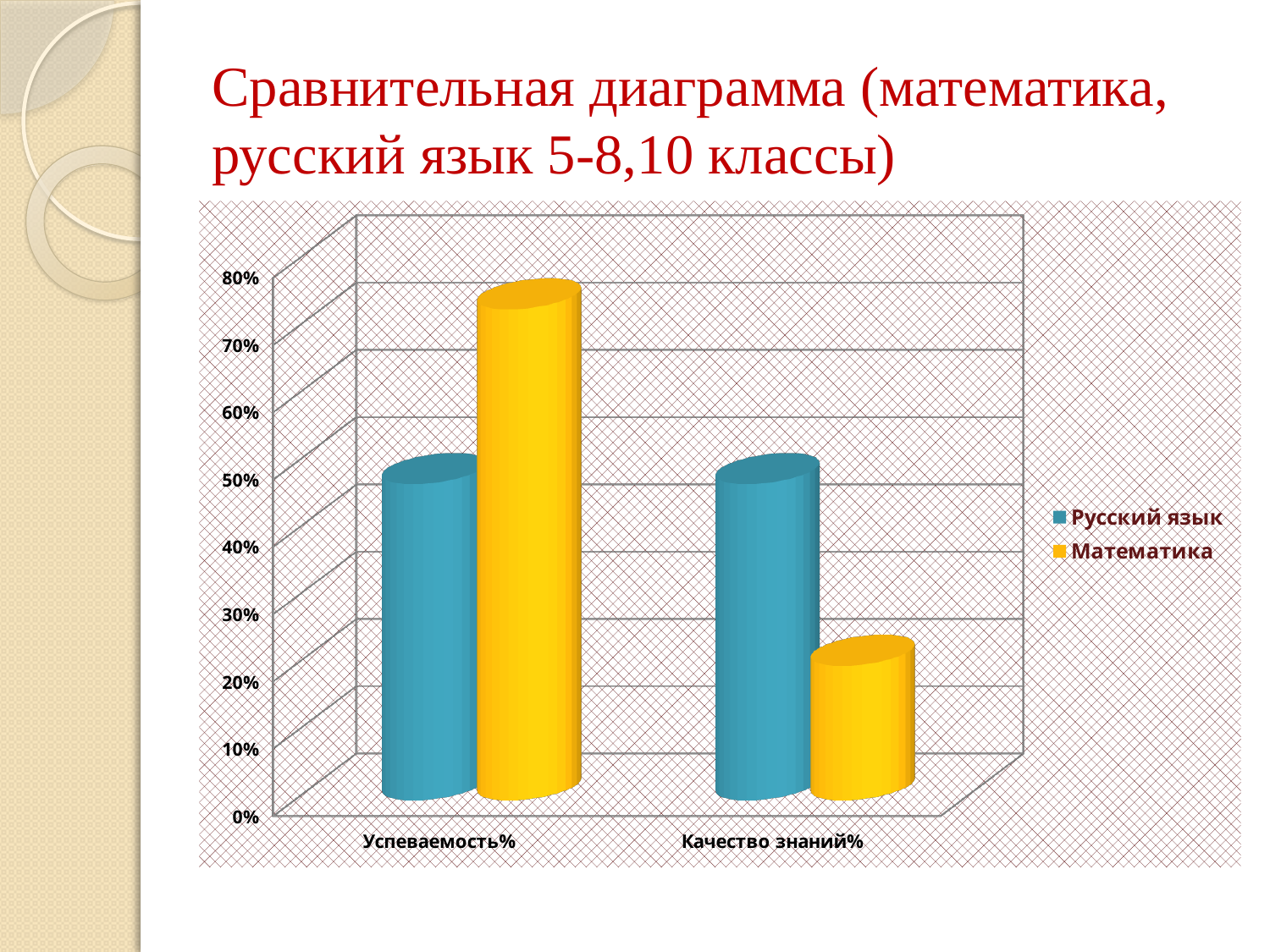
Does the value for Математика rise or fall from Успеваемость% to Качество знаний%? fall What kind of chart is shown on the slide? bar chart How many series does the legend list? 2 Which bar is the tallest in the chart? Математика, Успеваемость% Is the value for Математика in Качество знаний% greater or less than 30%? less Which colour represents Русский язык in the legend? blue Which series has the higher value for Успеваемость%? Математика Which bar is the shortest in the chart? Математика, Качество знаний% Which series has the higher value for Качество знаний%? Русский язык Is the value for Русский язык in Успеваемость% greater or less than 40%? greater Is the value for Математика in Успеваемость% greater or less than 70%? greater How many categories are shown on the x axis? 2